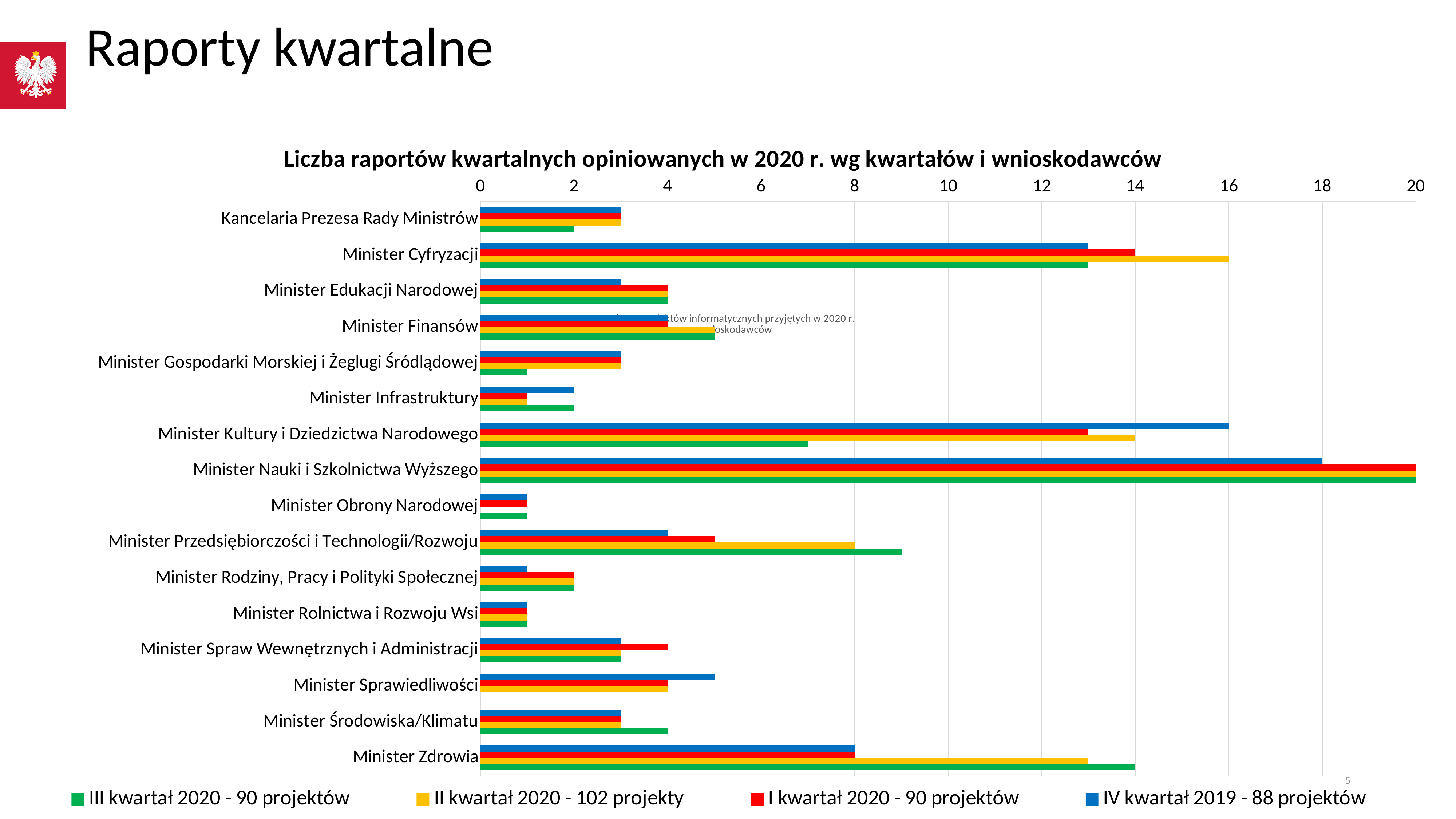
Which applicant has the highest value in the series 'II kwartał 2020 - 102 projekty'? Minister Nauki i Szkolnictwa Wyższego What is the value for Minister Kultury i Dziedzictwa Narodowego in the series 'IV kwartał 2019 - 88 projektów'? 16 For Minister Zdrowia, which is larger: the value for 'II kwartał 2020 - 102 projekty' or for 'IV kwartał 2019 - 88 projektów'? II kwartał 2020 - 102 projekty What is the value for Minister Cyfryzacji in the series 'II kwartał 2020 - 102 projekty'? 16 What is the value for Minister Zdrowia in the series 'III kwartał 2020 - 90 projektów'? 14 What type of chart is shown on the slide? bar chart For Minister Zdrowia, what is the difference between the value for 'III kwartał 2020 - 90 projektów' and the value for 'IV kwartał 2019 - 88 projektów'? 6 What is the value for Minister Nauki i Szkolnictwa Wyższego in the series 'IV kwartał 2019 - 88 projektów'? 18 How many applicant categories are shown on the y axis? 16 How many series does the legend list? 4 Is the value for Minister Cyfryzacji in the series 'IV kwartał 2019 - 88 projektów' greater or less than 12? greater Is the value for Minister Przedsiębiorczości i Technologii/Rozwoju in the series 'III kwartał 2020 - 90 projektów' greater or less than 8? greater